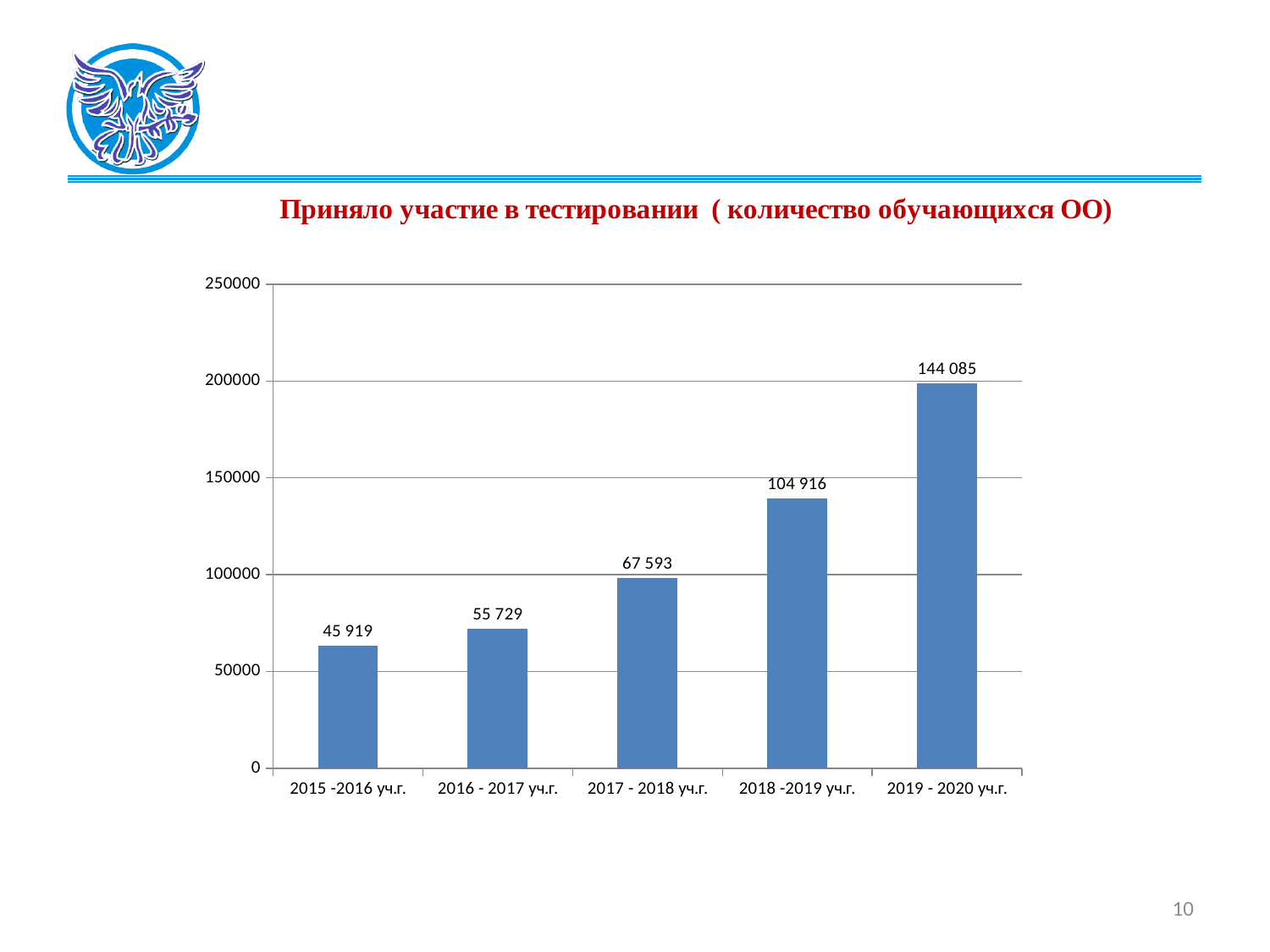
What kind of chart is this? bar chart Do the values rise or fall from 2015 -2016 уч.г. to 2019 - 2020 уч.г.? rise What value is shown for 2017 - 2018 уч.г.? 67 593 What is the difference between the values for 2016 - 2017 уч.г. and 2015 -2016 уч.г.? 9 810 Which academic year has the highest value? 2019 - 2020 уч.г. What value is shown for 2019 - 2020 уч.г.? 144 085 What is the difference between the values for 2019 - 2020 уч.г. and 2018 -2019 уч.г.? 39 169 What value is shown for 2015 -2016 уч.г.? 45 919 What value is shown for 2018 -2019 уч.г.? 104 916 Which is larger, the value for 2017 - 2018 уч.г. or the value for 2016 - 2017 уч.г.? 2017 - 2018 уч.г. Which academic year has the lowest value? 2015 -2016 уч.г. How many academic years are shown on the chart? 5